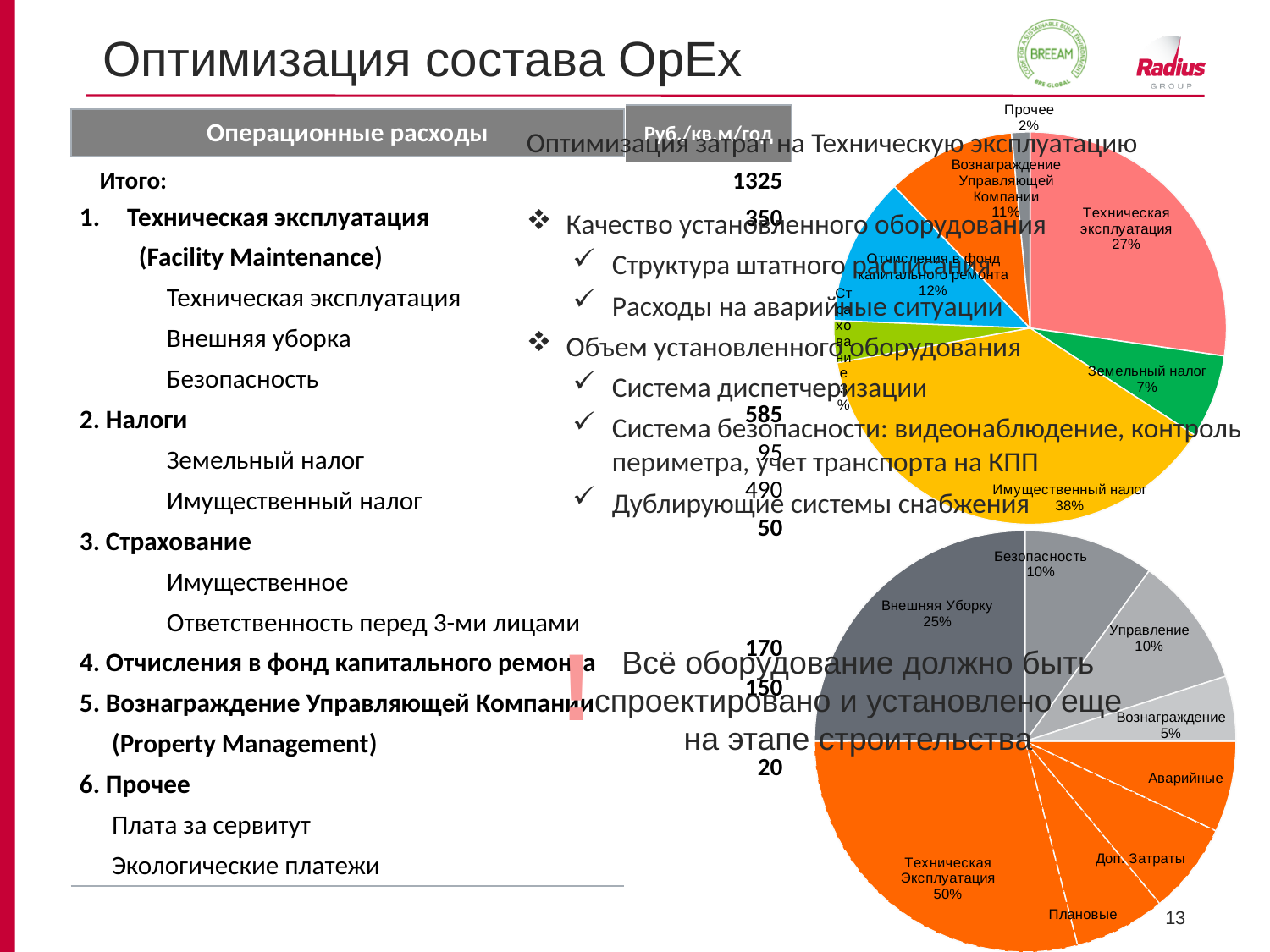
In the top pie chart, what share does Техническая эксплуатация have? 27% In the top pie chart, which category has the smallest share? Прочее In the bottom pie chart, what share does Внешняя Уборка have? 25% In the top pie chart, what is the difference in percentage points between Имущественный налог and Техническая эксплуатация? 11 What type of chart is the top chart on the slide? Pie chart In the bottom pie chart, what share does Техническая Эксплуатация have? 50% In the bottom pie chart, which category has the largest share? Техническая Эксплуатация In the bottom pie chart, which labelled category has the smallest share? Вознаграждение In the top pie chart, what share does Имущественный налог have? 38% In the top pie chart, which category has the largest share? Имущественный налог In the top pie chart, which is larger: Земельный налог or Отчисления в фонд капитального ремонта? Отчисления в фонд капитального ремонта In the bottom pie chart, what is the difference in percentage points between Внешняя Уборка and Безопасность? 15